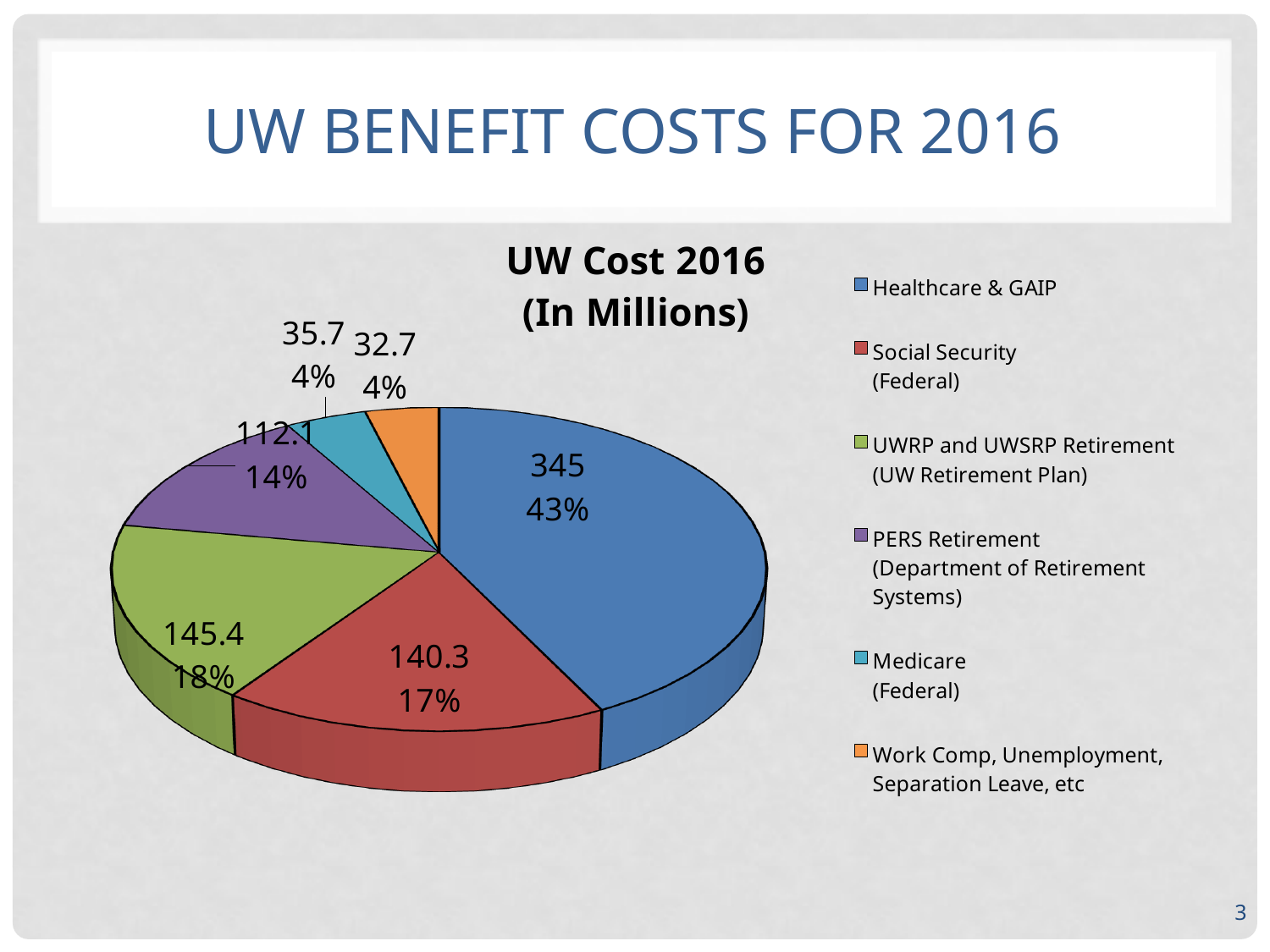
What kind of chart is shown on the slide? Pie chart What is the difference between the values for Healthcare & GAIP and Social Security (Federal)? 204.7 What share of the pie does Healthcare & GAIP represent? 43% What is the value for Healthcare & GAIP? 345 Which category has the smallest slice? Work Comp, Unemployment, Separation Leave, etc Which category has the largest slice? Healthcare & GAIP How many categories does the legend list? 6 What is the value for UWRP and UWSRP Retirement (UW Retirement Plan)? 145.4 What is the value for Social Security (Federal)? 140.3 What is the value for PERS Retirement (Department of Retirement Systems)? 112.1 Which is larger, the value for UWRP and UWSRP Retirement or the value for PERS Retirement? UWRP and UWSRP Retirement What share of the pie does Medicare (Federal) represent? 4%